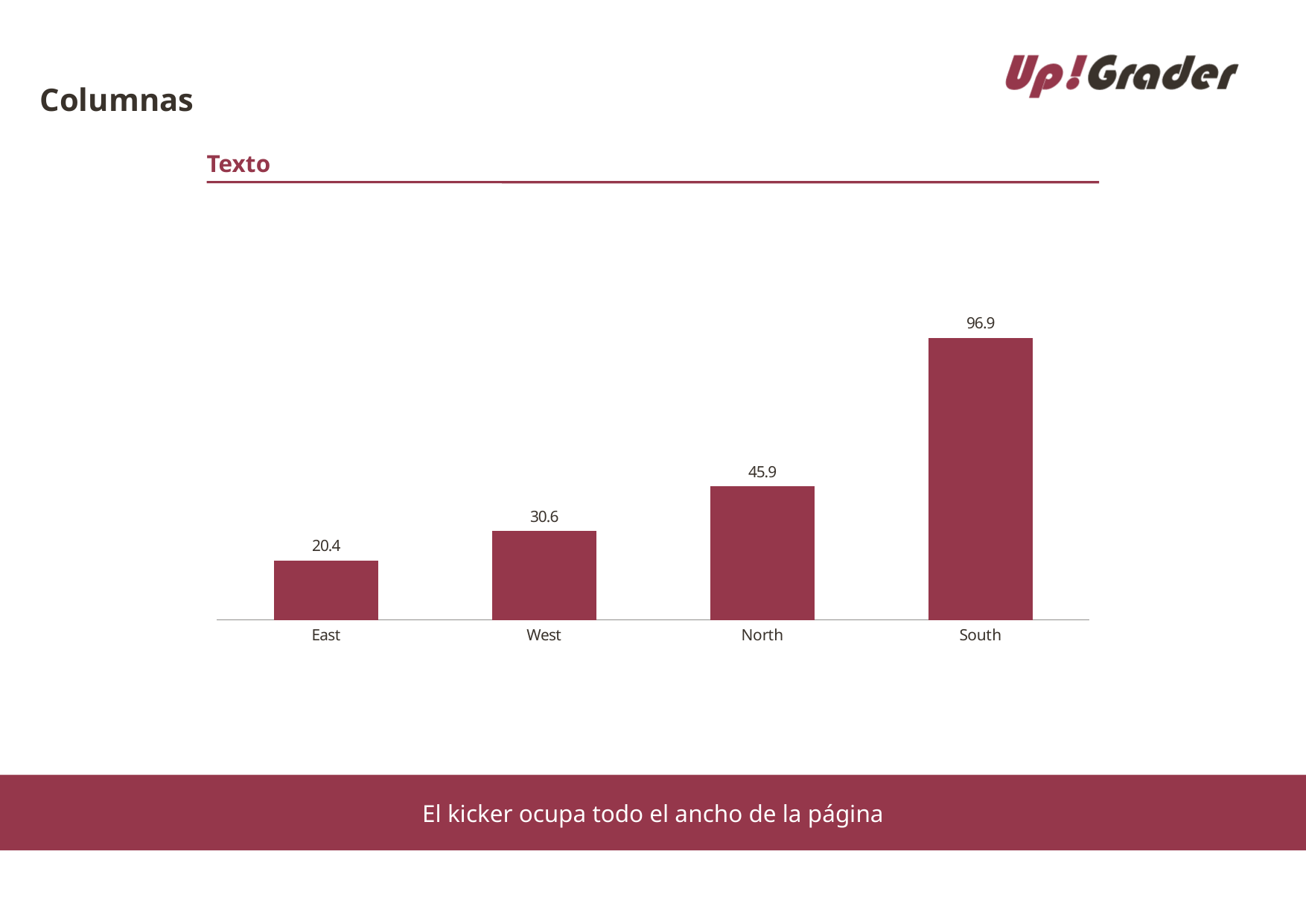
Do the values rise or fall from East to South along the x axis? Rise What kind of chart is shown on the slide? Bar chart What is the value for North? 45.9 What is the value for West? 30.6 What is the difference between the values for South and North? 51.0 Which category has the lowest value? East Which is larger, the value for North or the value for West? North What is the difference between the values for West and East? 10.2 What is the value for East? 20.4 How many categories are shown on the x axis? 4 Which category has the highest value? South What is the value for South? 96.9